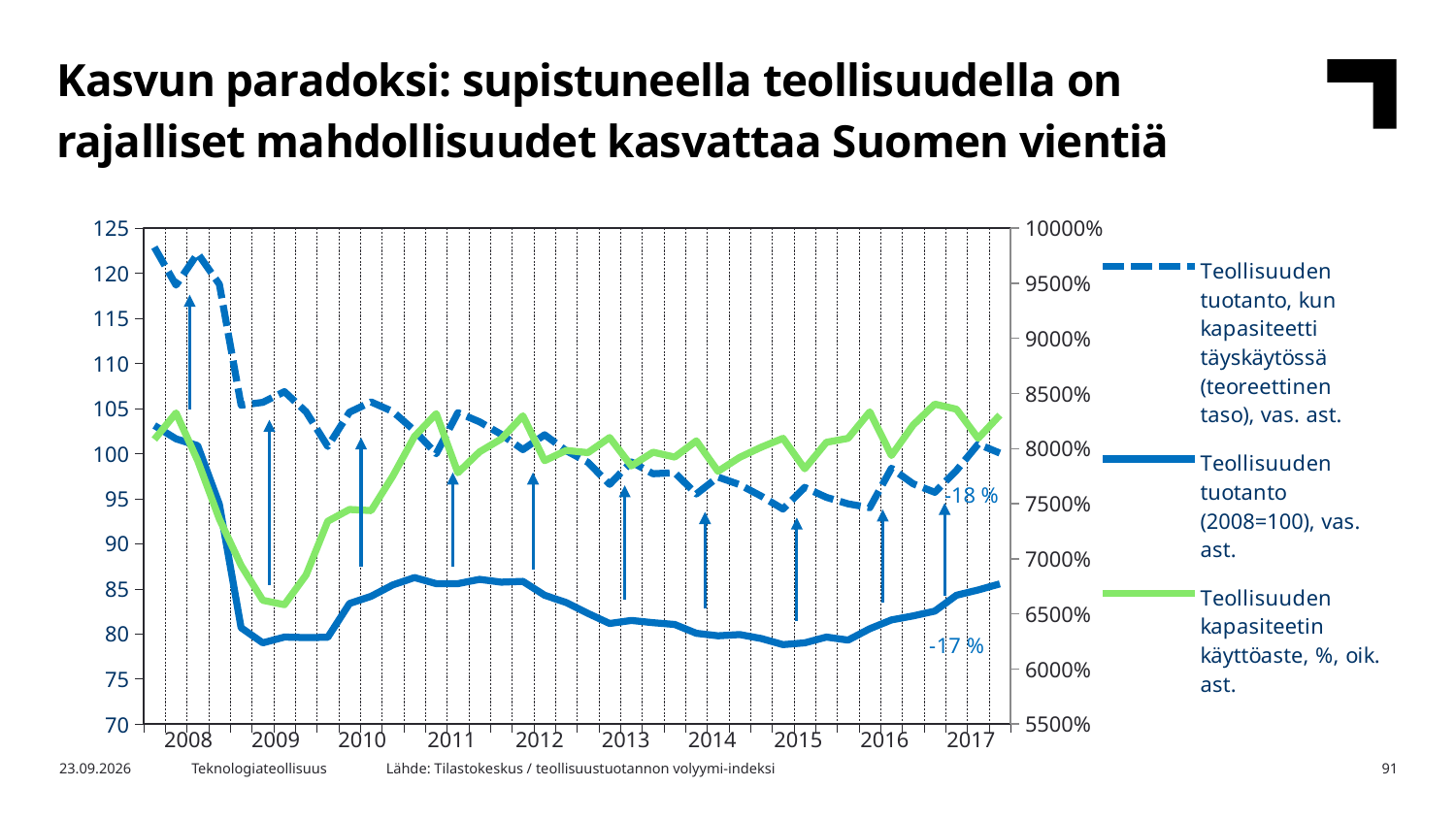
Which year is the first labelled on the x axis? 2008 What kind of chart is shown on the slide? line chart Is the value of the green line (kapasiteetin käyttöaste) at its 2009 low greater or less than 7000%? less How many years are labelled on the x axis? 10 How many series does the legend list? 3 Is the value of the solid blue line (Teollisuuden tuotanto, 2008=100) in 2012 greater or less than 80? greater What is the maximum value shown on the left vertical axis? 125 What percentage change is annotated next to the dashed blue line at the right end of the chart? -18 % Is the value of the dashed blue line at the start of 2008 greater or less than 120? greater Does the solid blue line (Teollisuuden tuotanto, 2008=100) rise or fall overall from 2008 to 2017? fall In 2009, which is higher: the dashed blue line or the solid blue line? the dashed blue line